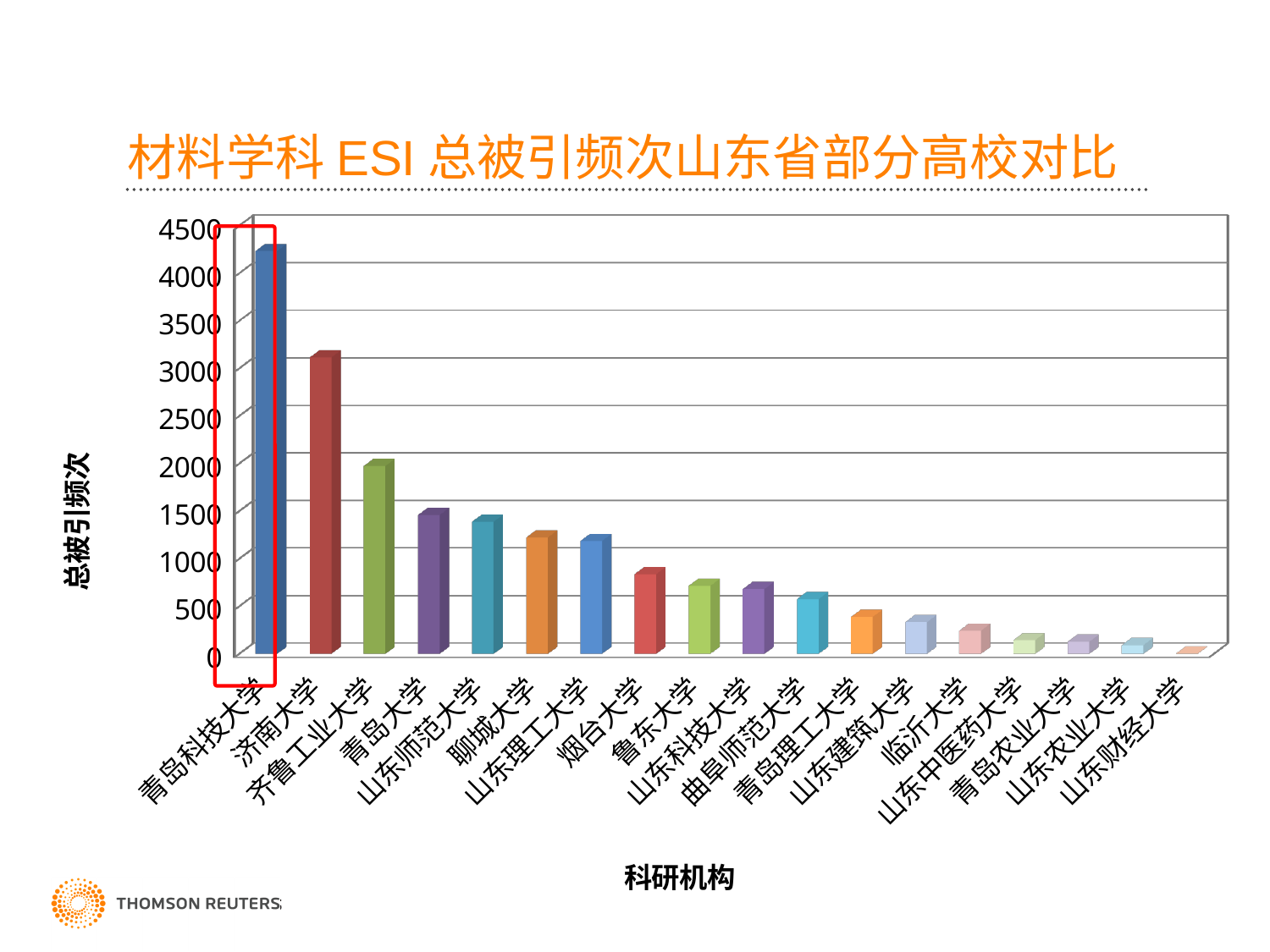
Which has a higher value, 济南大学 or 齐鲁工业大学? 济南大学 What is the label of the y axis? 总被引频次 Is the value for 青岛科技大学 greater or less than 4000? greater Is the value for 青岛理工大学 greater or less than 500? less Do the values rise or fall moving from left to right along the x axis? fall How many institutions are shown on the x axis? 18 Is the value for 烟台大学 greater or less than 1000? less Which institution has the lowest total citation count? 山东财经大学 Which institution has the highest total citation count (总被引频次)? 青岛科技大学 What kind of chart is shown on the slide? bar chart